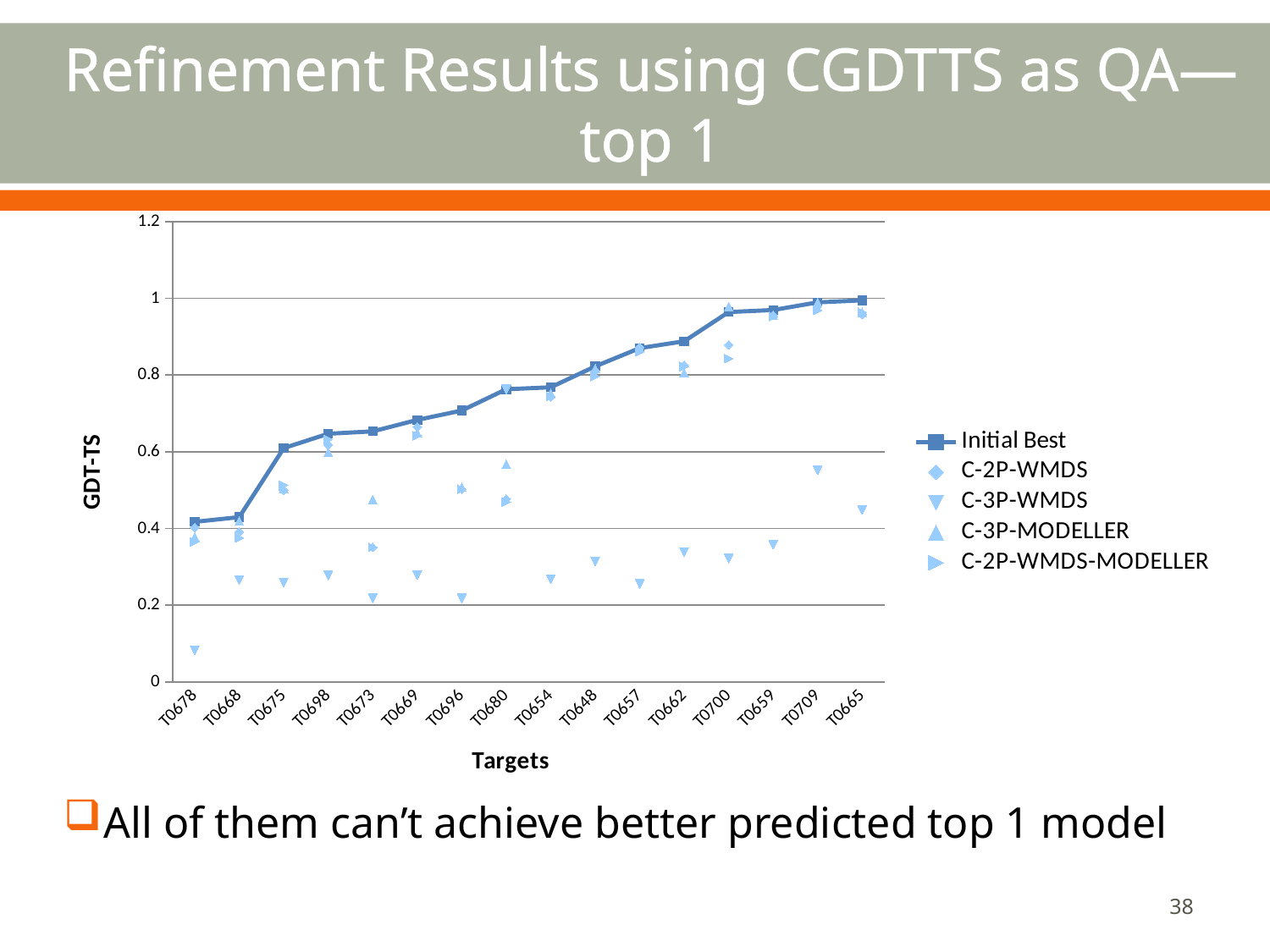
Is the Initial Best value for T0675 greater or less than 0.8? less For which target is the Initial Best value lowest? T0678 Is the Initial Best value for T0700 greater or less than 0.8? greater How many targets are shown along the x axis? 16 How many series does the legend list? 5 Does the Initial Best series rise or fall from T0678 to T0665 along the x axis? Rises What kind of chart is shown on the slide? Line chart with scatter points Which series is drawn as a solid line with square markers? Initial Best Which is larger, the Initial Best value for T0648 or for T0698? T0648 Is the Initial Best value for T0678 greater or less than 0.6? less What is the label of the y axis? GDT-TS For which target is the Initial Best value highest? T0665